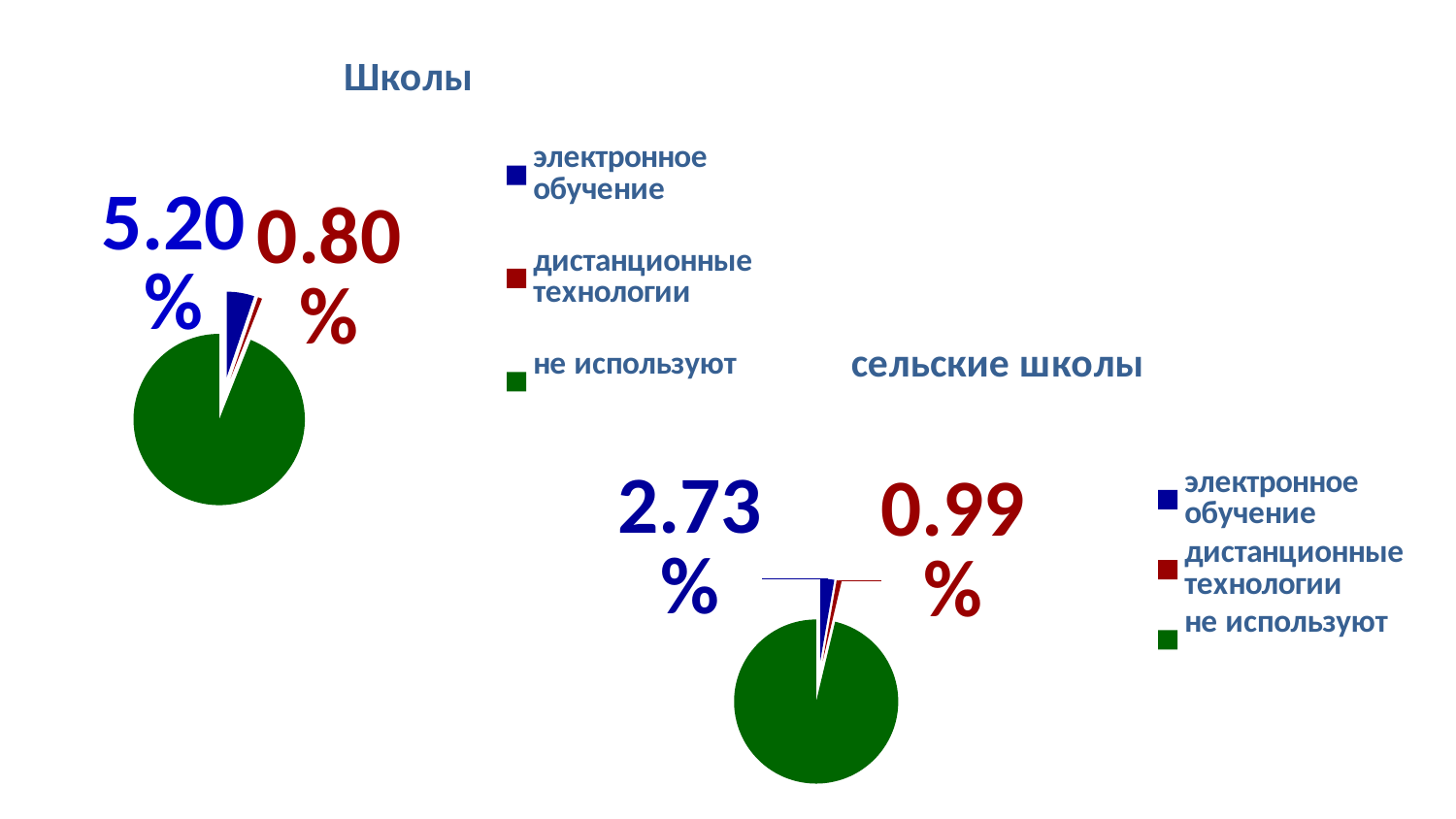
How many categories does the legend of the "сельские школы" chart list? 3 What kind of chart is the "Школы" chart? pie chart In the "Школы" chart, what is the difference between электронное обучение and дистанционные технологии? 4.40% In the "Школы" chart, what is the value for дистанционные технологии? 0.80% In the "сельские школы" chart, what is the value for дистанционные технологии? 0.99% In the "сельские школы" chart, which category has the smallest slice? дистанционные технологии In the "сельские школы" chart, what is the difference between электронное обучение and дистанционные технологии? 1.74% In the "Школы" chart, what is the value for электронное обучение? 5.20% In the "Школы" chart, what colour is the slice for не используют? green In the "сельские школы" chart, what is the value for электронное обучение? 2.73% Which is larger: электронное обучение in the "Школы" chart or электронное обучение in the "сельские школы" chart? Школы In the "Школы" chart, which category has the largest slice? не используют